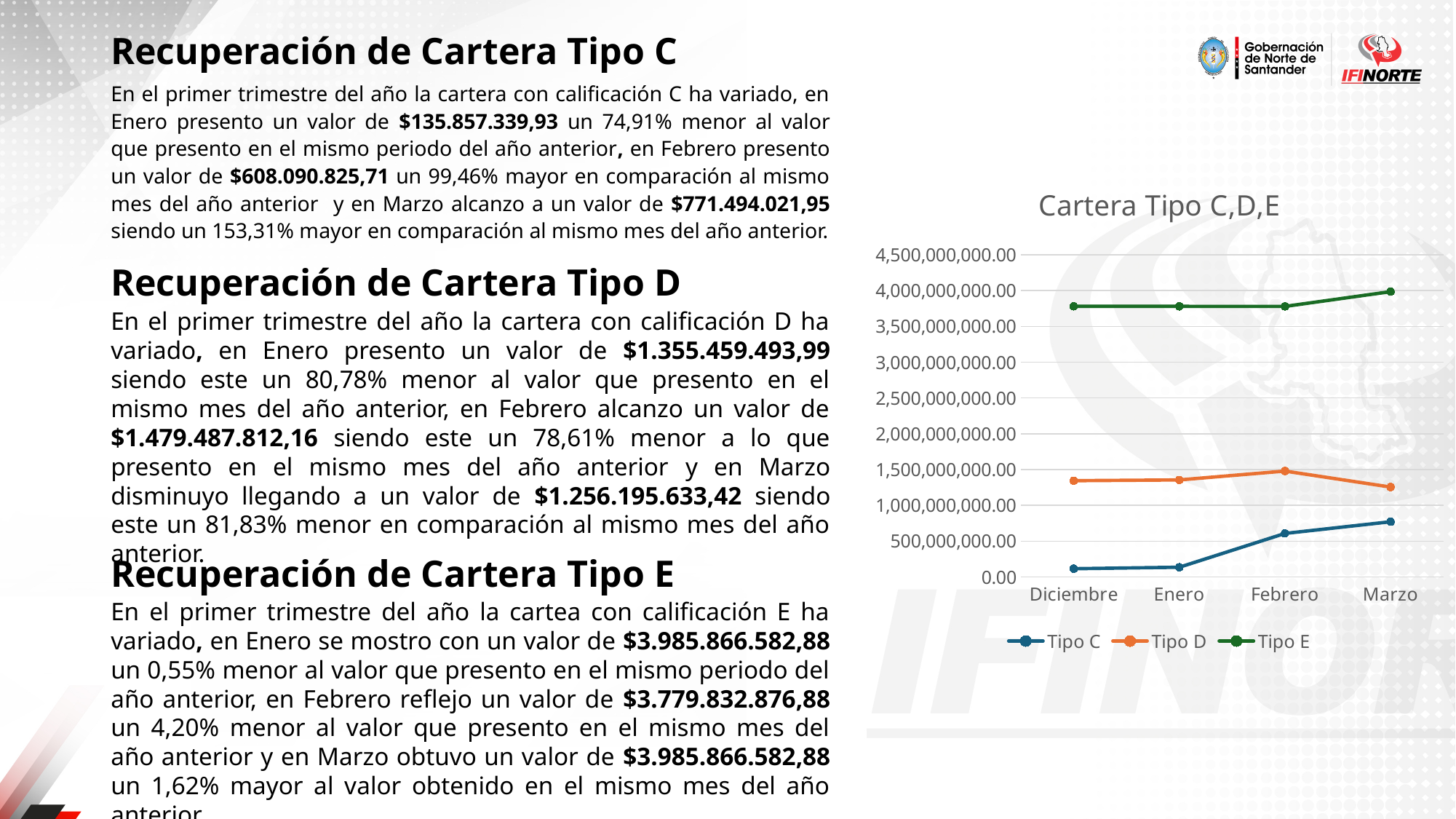
What is the title of the chart? Cartera Tipo C,D,E Is the value for Tipo C in Marzo greater or less than 500,000,000.00? greater In which month does Tipo C reach its highest value? Marzo Is the value for Tipo E in Diciembre greater or less than 3,500,000,000.00? greater How many months are shown on the x axis of the chart? 4 Does the Tipo C line rise or fall from Diciembre to Marzo? Rises Which series has the highest values across all months in the chart? Tipo E Which series has the lowest values across all months in the chart? Tipo C What kind of chart is shown on the slide? Line chart Is the value for Tipo C in Diciembre greater or less than 500,000,000.00? less In which month does Tipo D have its lowest value? Marzo How many series does the chart legend list? 3